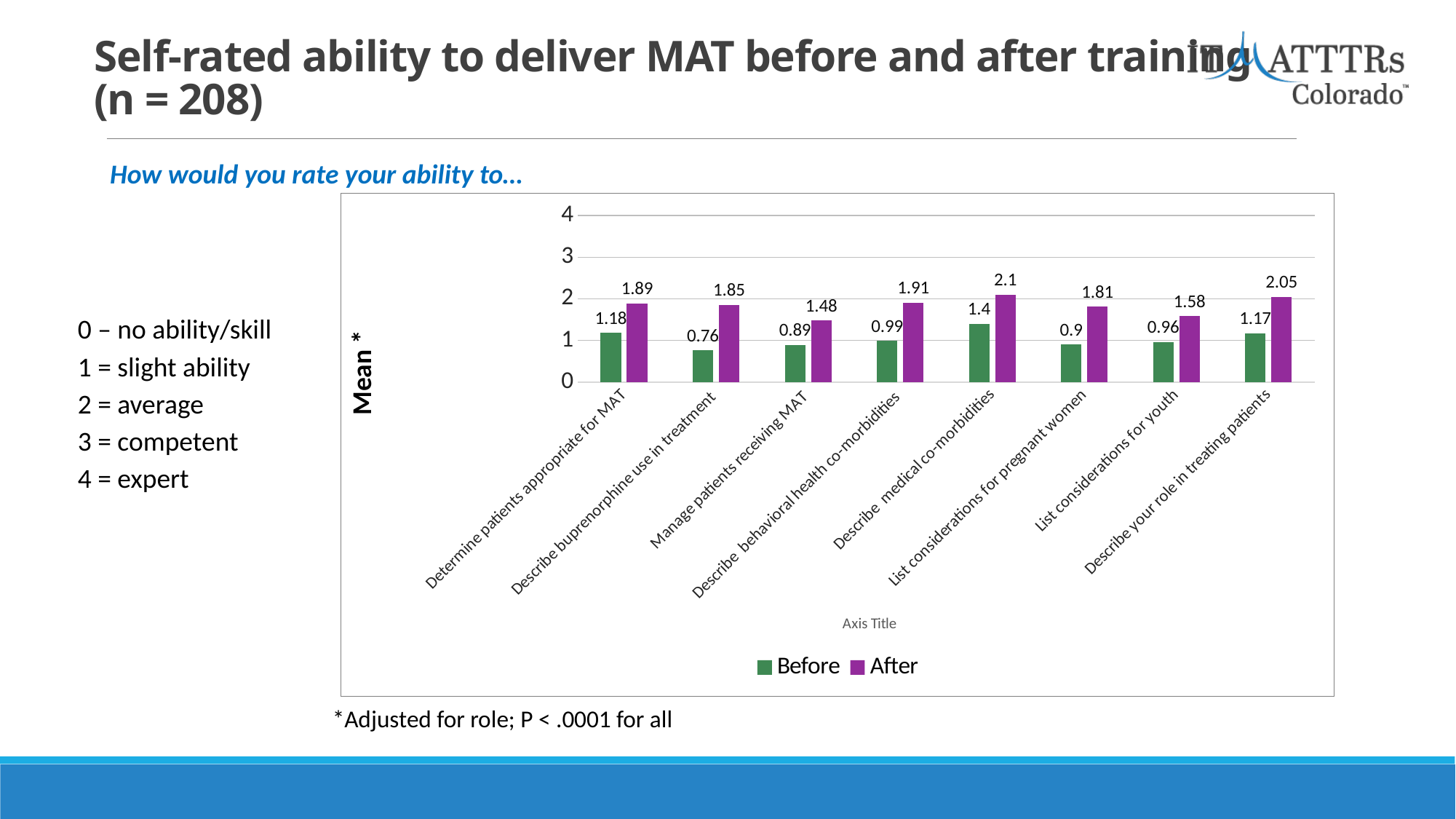
How many series does the legend list? 2 Is the After value for "Describe your role in treating patients" greater or less than 2? greater Which category has the lowest Before value? Describe buprenorphine use in treatment Which category has the highest After value? Describe medical co-morbidities Which is larger: the After value for "Manage patients receiving MAT" or the After value for "List considerations for youth"? List considerations for youth What is the label on the vertical axis of the chart? Mean * What is the Before value for "Describe buprenorphine use in treatment"? 0.76 What kind of chart is shown on the slide? Bar chart What is the Before value for "Determine patients appropriate for MAT"? 1.18 What is the After value for "Describe medical co-morbidities"? 2.1 How many categories are shown on the x axis? 8 What is the difference between the After and Before values for "Describe buprenorphine use in treatment"? 1.09